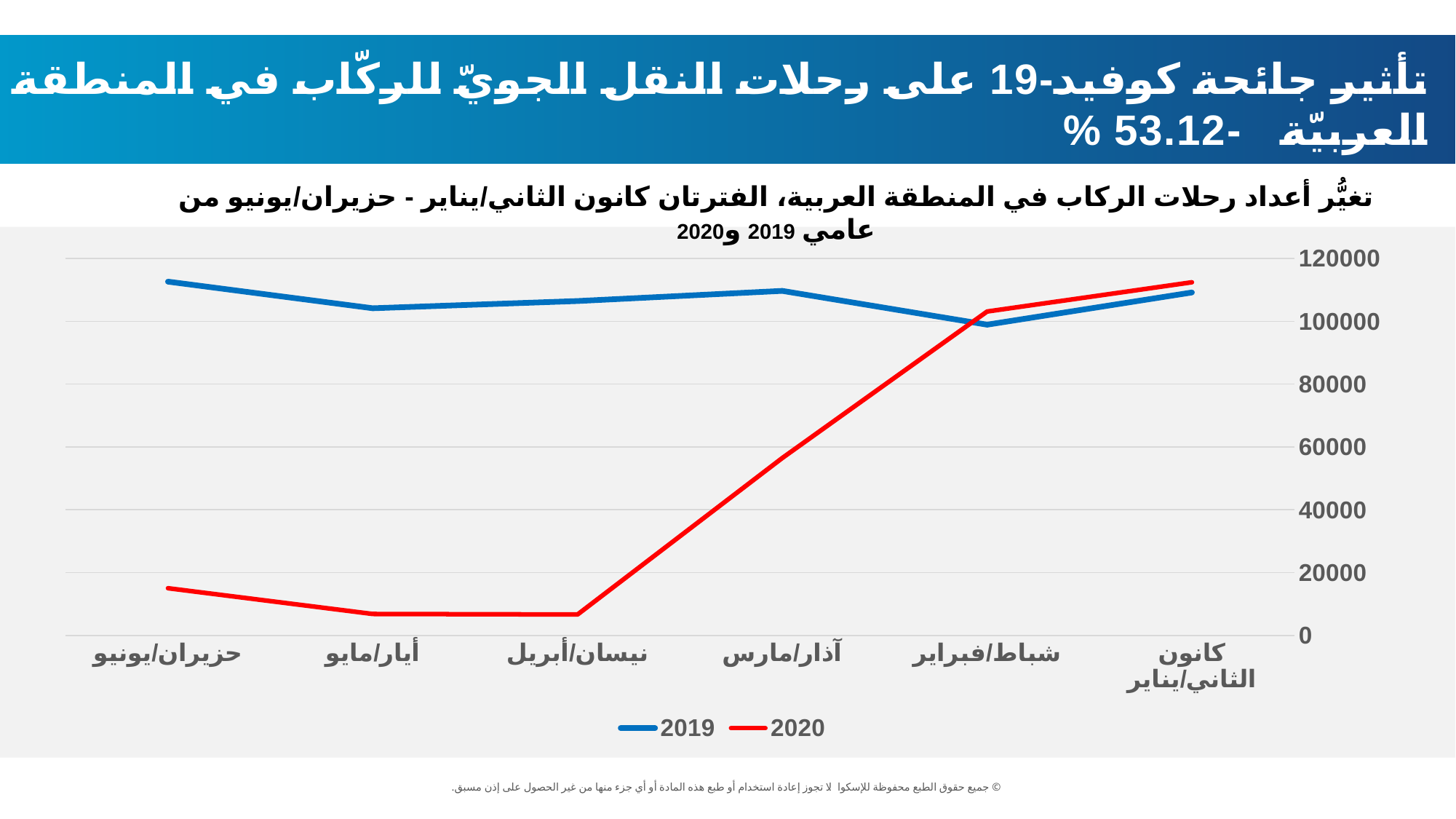
Does the 2020 series rise or fall from كانون الثاني/يناير to نيسان/أبريل? fall Is the 2020 value for كانون الثاني/يناير greater or less than 100000? greater Is the 2020 value for نيسان/أبريل greater or less than 20000? less For the 2019 series, which month has the lowest value? شباط/فبراير What colour is the line for the 2020 series? red In نيسان/أبريل, which series has the larger value, 2019 or 2020? 2019 How many series does the legend list? 2 For the 2020 series, which month has the highest value? كانون الثاني/يناير What kind of chart is shown on the slide? line chart How many months are plotted along the x axis? 6